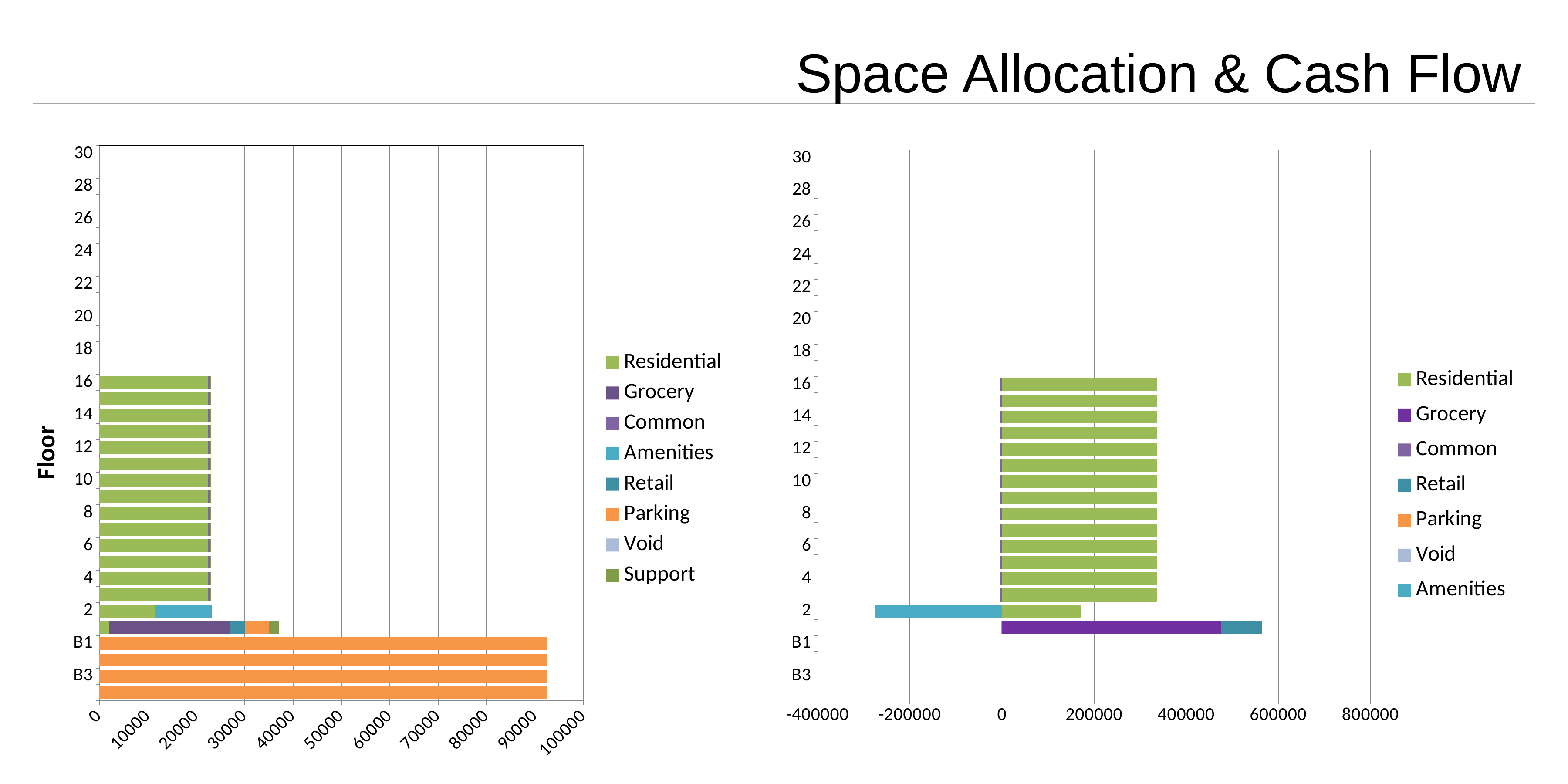
What kind of chart is the left chart on the slide? bar chart What kind of chart is the right chart on the slide? bar chart On the left chart, is the total length of the stacked bar for floor 1 greater or less than 30000? greater On the right chart, which is larger: the Residential bar for floor 2 or the Residential bar for floor 10? Residential bar for floor 10 On the left chart, is the Parking value for floor B1 greater or less than 80000? greater On the left chart, what is the title of the vertical axis? Floor How many series does the legend of the left chart list? 8 On the left chart, which is larger: the Parking bar for floor B1 or the Residential bar for floor 10? Parking bar for floor B1 How many series does the legend of the right chart list? 7 On the left chart, is the Residential value for floor 10 greater or less than 30000? less